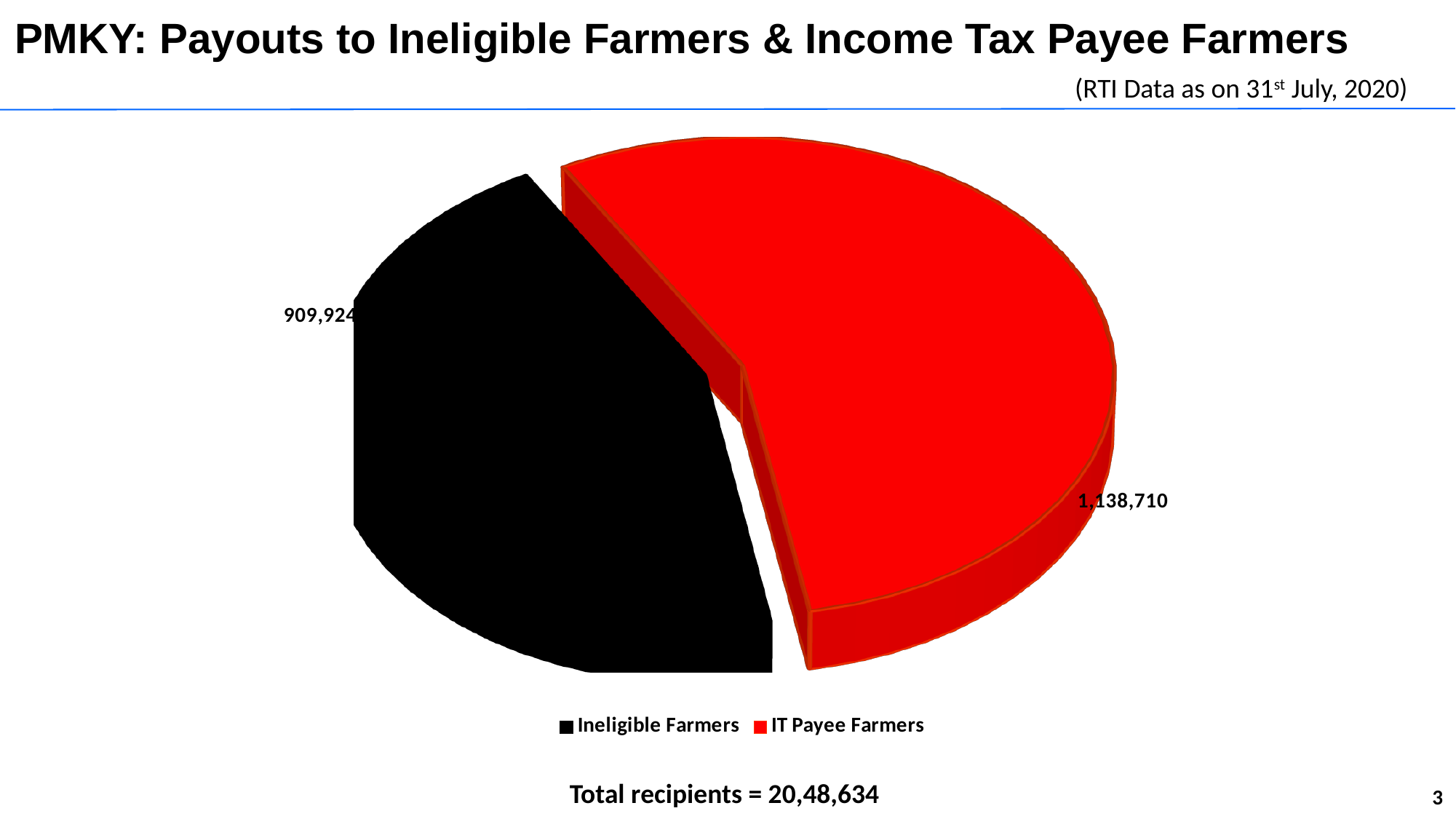
Which category has the largest slice of the pie? IT Payee Farmers What colour is the slice for IT Payee Farmers? Red What is the value shown for Ineligible Farmers? 909,924 How many slices does the pie chart have? 2 What is the difference between the value for IT Payee Farmers and the value for Ineligible Farmers? 228,786 What is the title of the slide? PMKY: Payouts to Ineligible Farmers & Income Tax Payee Farmers How many entries does the legend list? 2 What is the value shown for IT Payee Farmers? 1,138,710 Which category has the smallest slice of the pie? Ineligible Farmers Which is larger, the value for Ineligible Farmers or the value for IT Payee Farmers? IT Payee Farmers What is the total number of recipients stated on the slide? 20,48,634 What kind of chart is shown on the slide? Pie chart